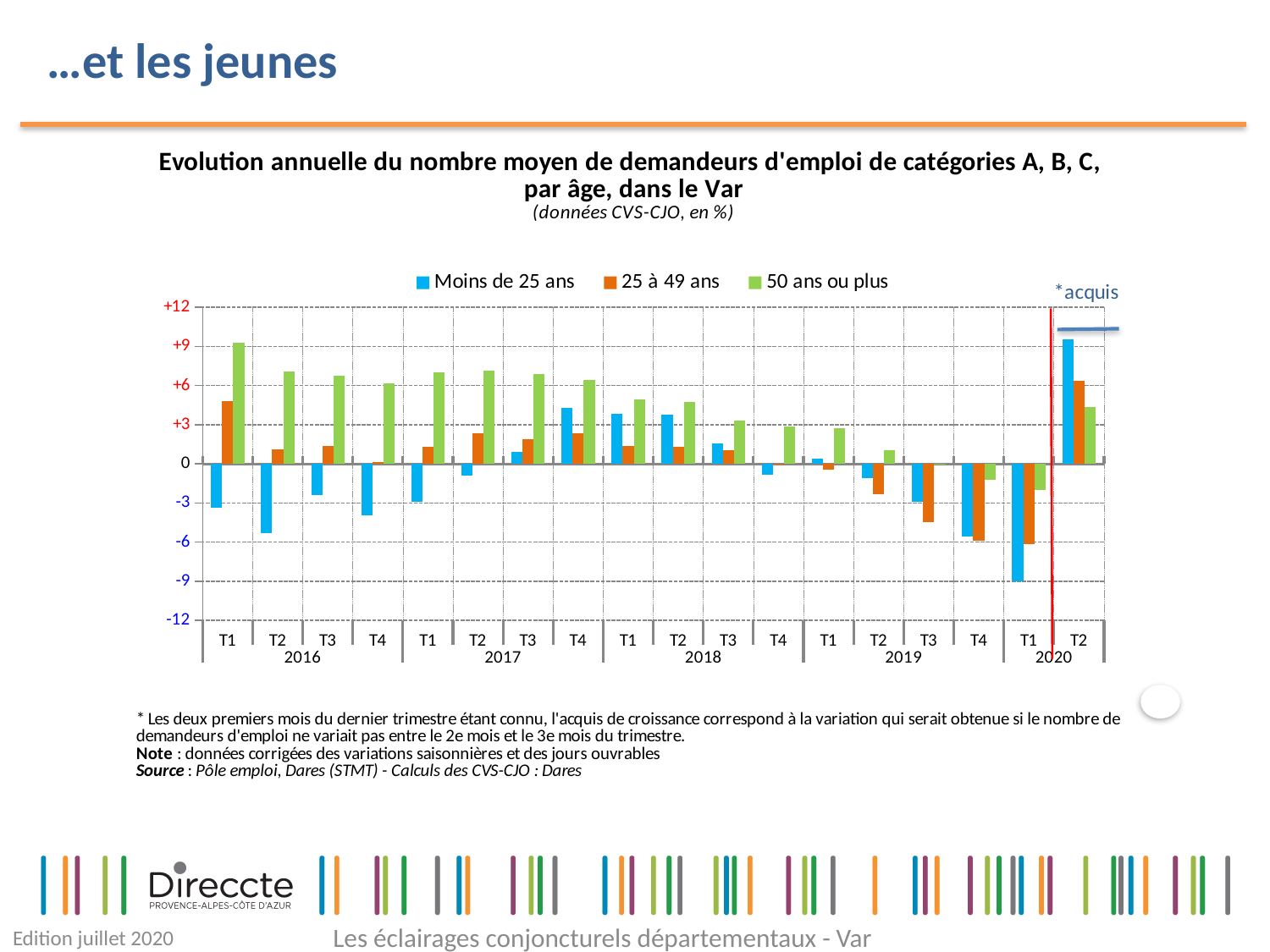
In which quarter does 'Moins de 25 ans' reach its lowest value? T1 2020 Do the values for '50 ans ou plus' rise or fall from T1 2018 to T1 2020? fall What colour represents 'Moins de 25 ans' in the legend? Blue What kind of chart is shown on the slide? Bar chart In T1 2016, which is larger: the value for '50 ans ou plus' or for '25 à 49 ans'? 50 ans ou plus Is the value for 'Moins de 25 ans' in T1 2020 greater or less than -6? less Is the value for '50 ans ou plus' in T1 2016 greater or less than +6? greater Is the value for '25 à 49 ans' in T4 2019 greater or less than -3? less How many quarters are shown along the x axis? 18 In T2 2020, which age group has the highest value? Moins de 25 ans How many series does the legend list? 3 In which quarter does '50 ans ou plus' reach its highest value? T1 2016